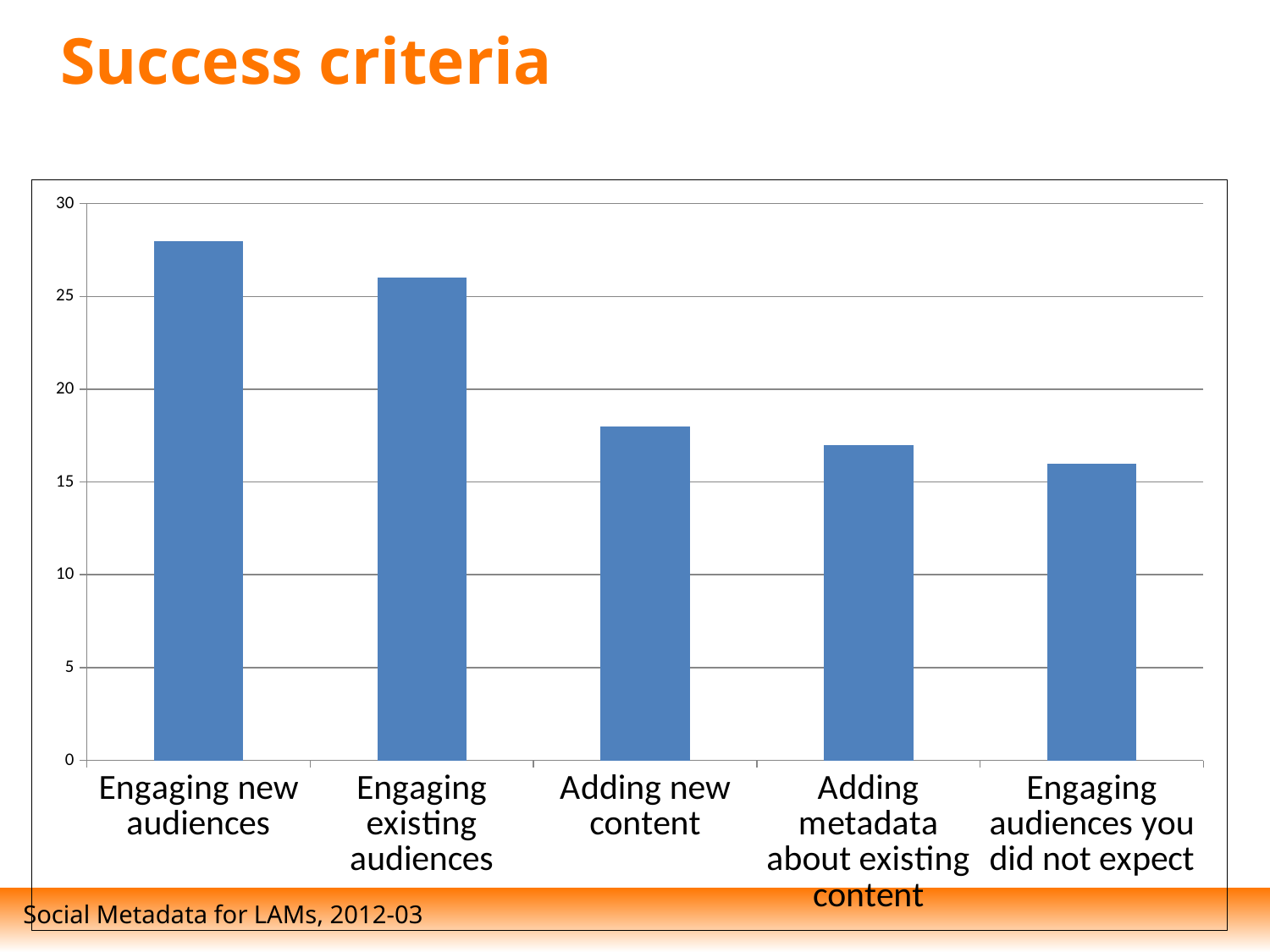
Is the value for Adding metadata about existing content greater or less than 15? greater Which category has the lowest bar? Engaging audiences you did not expect Do the bar values rise or fall from left to right along the x axis? fall Which category has the highest bar? Engaging new audiences What is the title of the slide containing the chart? Success criteria Is the value for Engaging new audiences greater or less than 25? greater Is the value for Engaging audiences you did not expect greater or less than 20? less Which is larger, the value for Engaging new audiences or the value for Engaging audiences you did not expect? Engaging new audiences What kind of chart is shown on the slide? bar chart How many categories are shown on the x axis of the chart? 5 Which is larger, the value for Engaging existing audiences or the value for Adding new content? Engaging existing audiences